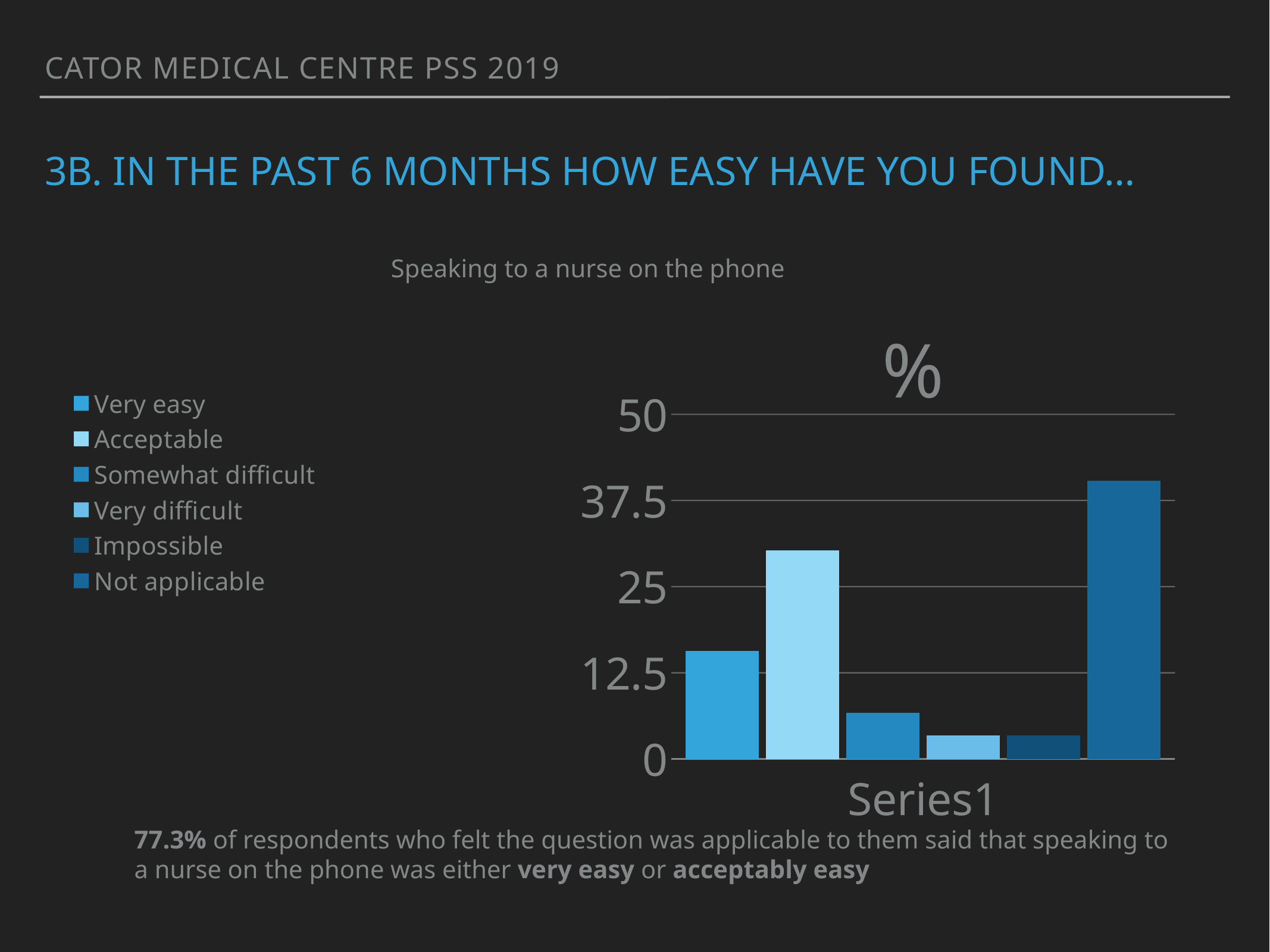
Is the value for Very easy greater or less than 12.5? greater Is the value for Not applicable greater or less than 37.5? greater Is the value for Very difficult greater or less than 12.5? less Which category has the highest bar in the chart? Not applicable How many bars are plotted in the chart? 6 What kind of chart is shown on the slide? bar chart How many entries does the chart's legend list? 6 Which is larger, the value for Acceptable or the value for Very easy? Acceptable What is the title of the chart? %